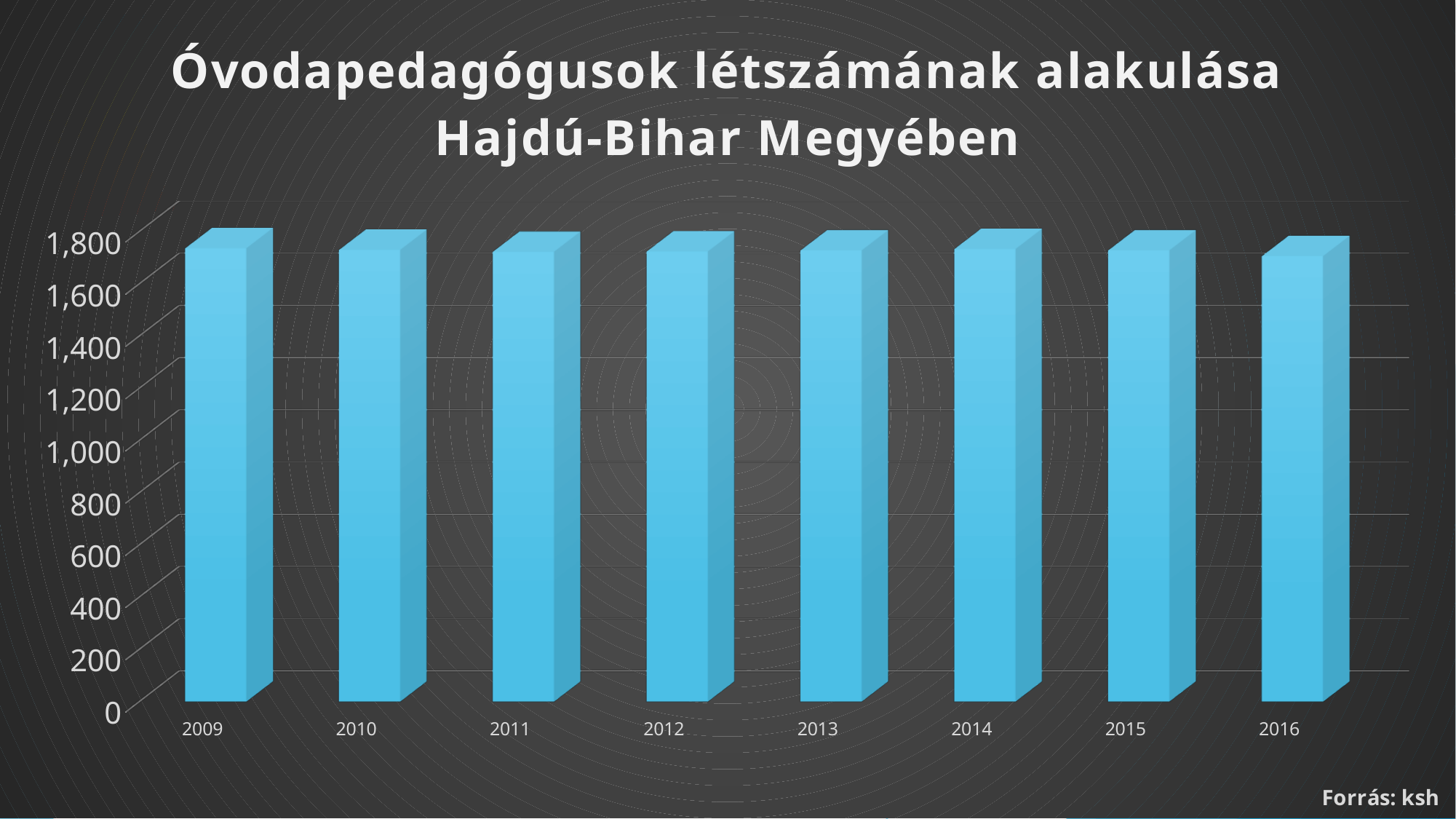
Is the value for 2016 greater or less than 1,600? greater What kind of chart is shown on the slide? bar chart What is the title of the chart? Óvodapedagógusok létszámának alakulása Hajdú-Bihar Megyében How many years are shown on the x axis of the chart? 8 Is the value for 2014 greater or less than 1,000? greater Is the value for 2012 greater or less than 1,400? greater What is the highest tick value shown on the vertical axis? 1,800 What is the first year shown on the x axis? 2009